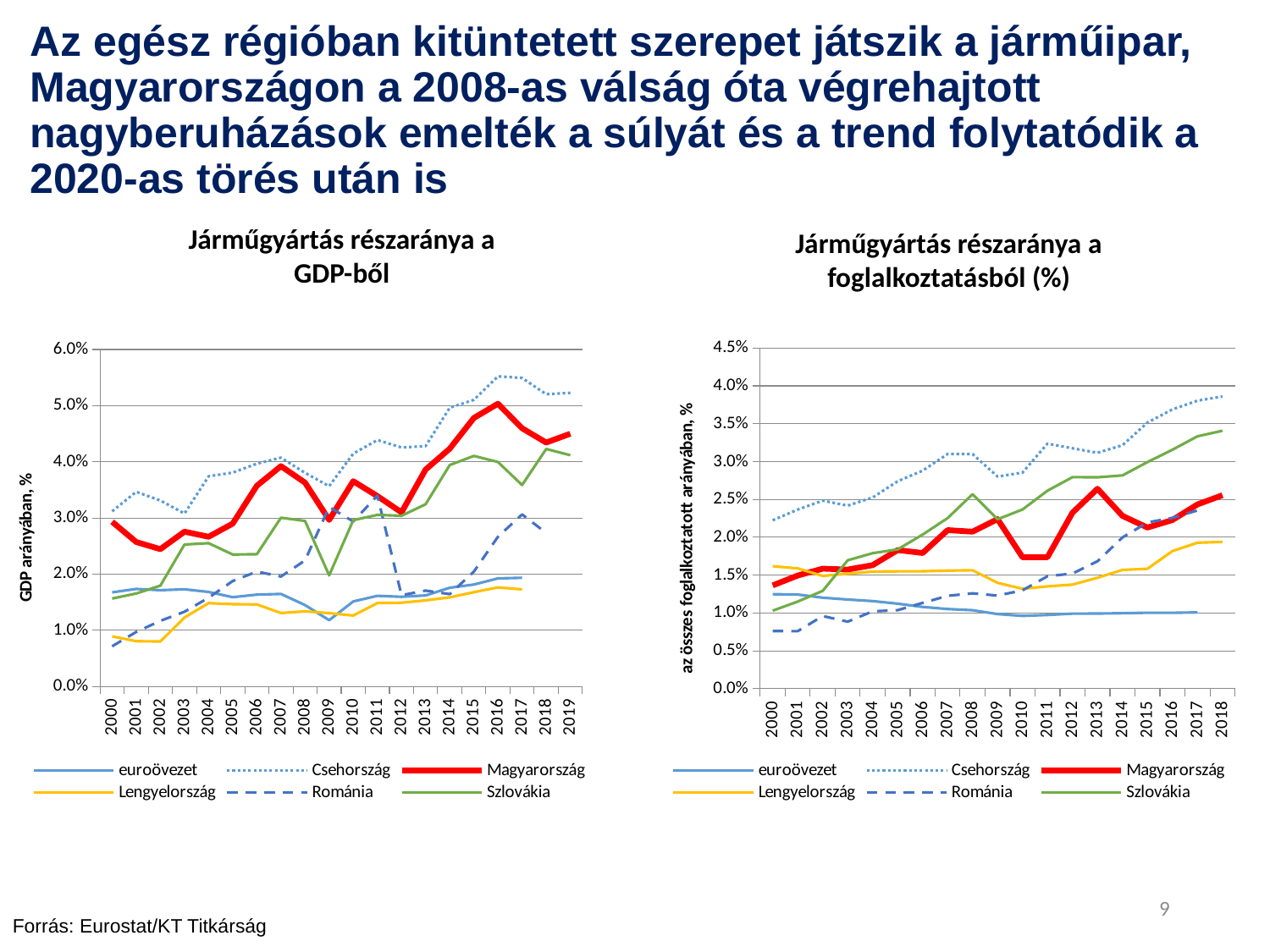
In the right chart, 'Járműgyártás részaránya a foglalkoztatásból (%)', which is larger in 2018: Szlovákia or Magyarország? Szlovákia What is the y-axis label of the left chart, 'Járműgyártás részaránya a GDP-ből'? GDP arányában, % In the right chart, 'Járműgyártás részaránya a foglalkoztatásból (%)', does the euroövezet series rise or fall overall from 2000 to 2018? fall In the left chart, 'Járműgyártás részaránya a GDP-ből', which country has the highest value in 2019? Csehország In the right chart, 'Járműgyártás részaránya a foglalkoztatásból (%)', is the value for Szlovákia in 2018 greater or less than 3.0%? greater How many years are shown on the x axis of the left chart, 'Járműgyártás részaránya a GDP-ből'? 20 In the left chart, 'Járműgyártás részaránya a GDP-ből', is the value for Románia in 2000 greater or less than 1.0%? less What kind of chart is the left chart, 'Járműgyártás részaránya a GDP-ből'? line chart How many series does the legend of the right chart, 'Járműgyártás részaránya a foglalkoztatásból (%)', list? 6 In the left chart, 'Járműgyártás részaránya a GDP-ből', is the value for Csehország in 2016 greater or less than 5.0%? greater How many years are shown on the x axis of the right chart, 'Járműgyártás részaránya a foglalkoztatásból (%)'? 19 In the right chart, 'Járműgyártás részaránya a foglalkoztatásból (%)', which series has the lowest value in 2018? Lengyelország